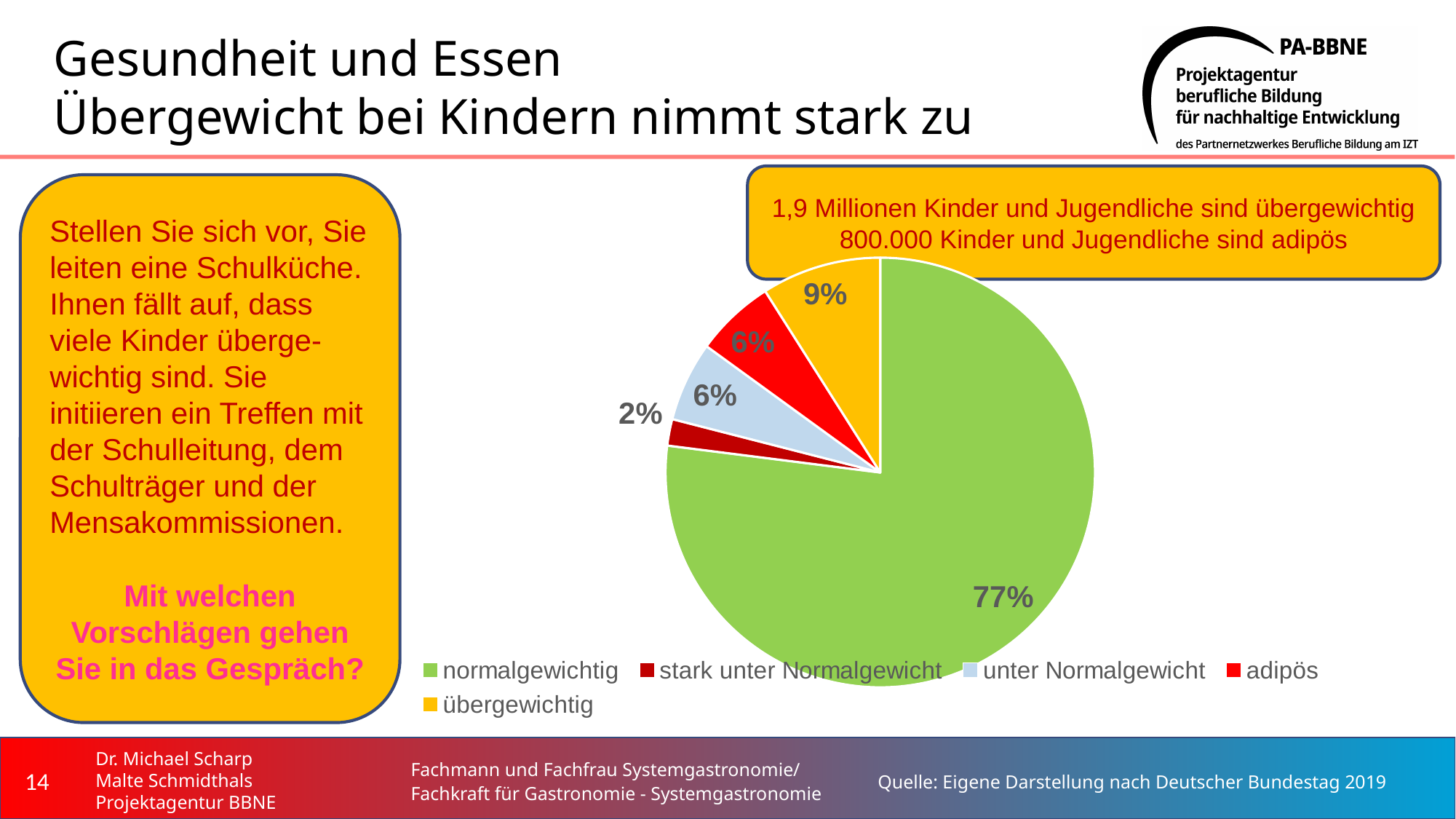
Which category has the smallest slice of the pie? stark unter Normalgewicht Which is larger, the slice for übergewichtig or the slice for stark unter Normalgewicht? übergewichtig What percentage is shown for unter Normalgewicht? 6% What percentage is shown for übergewichtig? 9% What percentage is shown for stark unter Normalgewicht? 2% What percentage is shown for adipös? 6% What is the difference in percentage points between übergewichtig and adipös? 3 How many categories does the legend list? 5 What kind of chart is shown on the slide? pie chart What share of the pie is labelled normalgewichtig? 77% Which category has the largest slice of the pie? normalgewichtig What colour is the slice for normalgewichtig? green